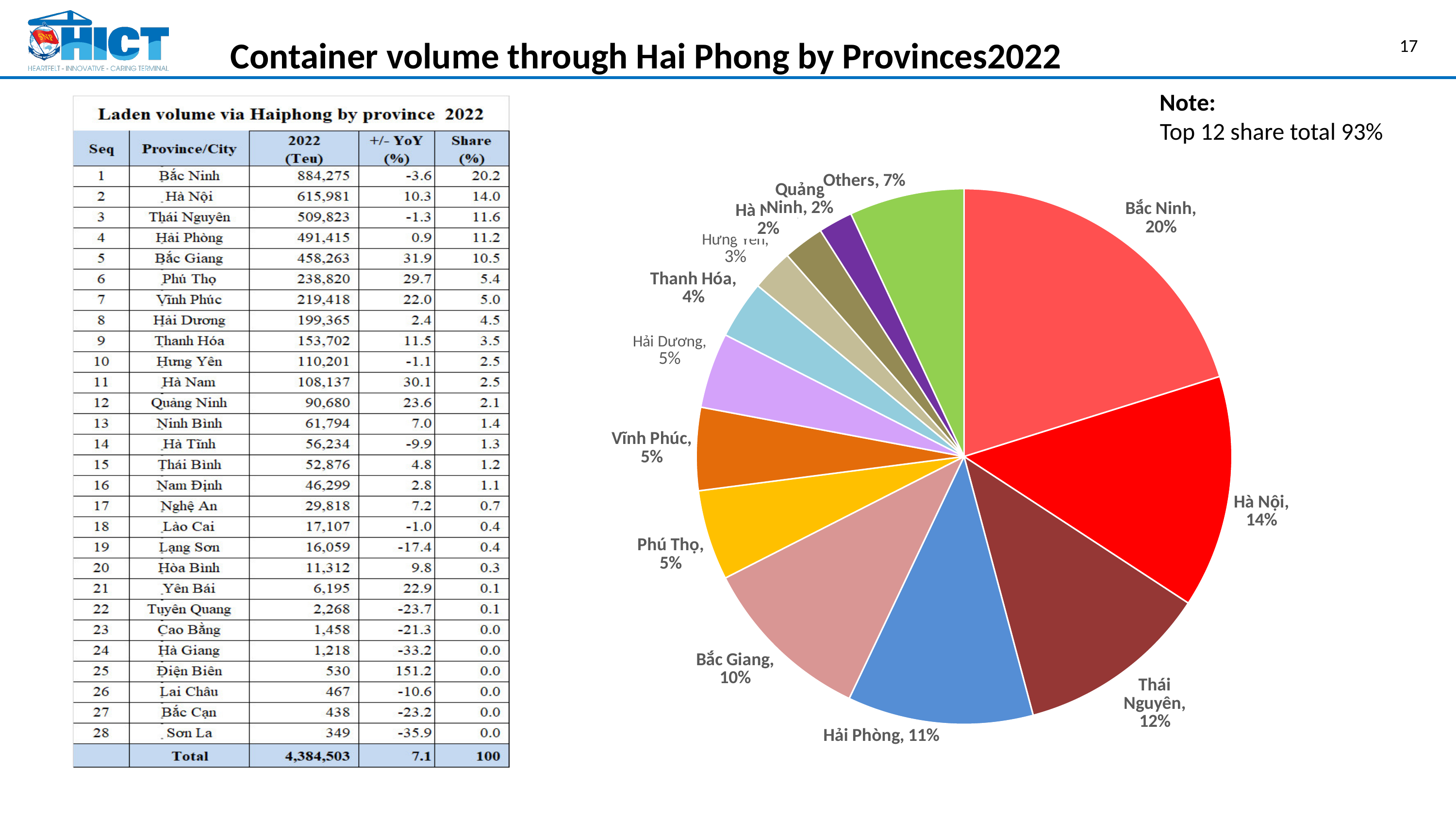
What kind of chart is shown on the slide? Pie chart Which province has the largest slice in the pie chart? Bắc Ninh How many slices does the pie chart have? 13 In the pie chart, what share does Thái Nguyên have? 12% In the pie chart, what share does Hà Nội have? 14% In the pie chart, what share does Bắc Ninh have? 20% In the pie chart, what share does Thanh Hóa have? 4% In the pie chart, what share does Others have? 7% In the pie chart, which is larger: the share of Hà Nội or the share of Thái Nguyên? Hà Nội In the pie chart, what share does Hải Phòng have? 11% In the pie chart, what share does Bắc Giang have? 10% In the pie chart, what is the difference between the share of Bắc Ninh and the share of Bắc Giang? 10%